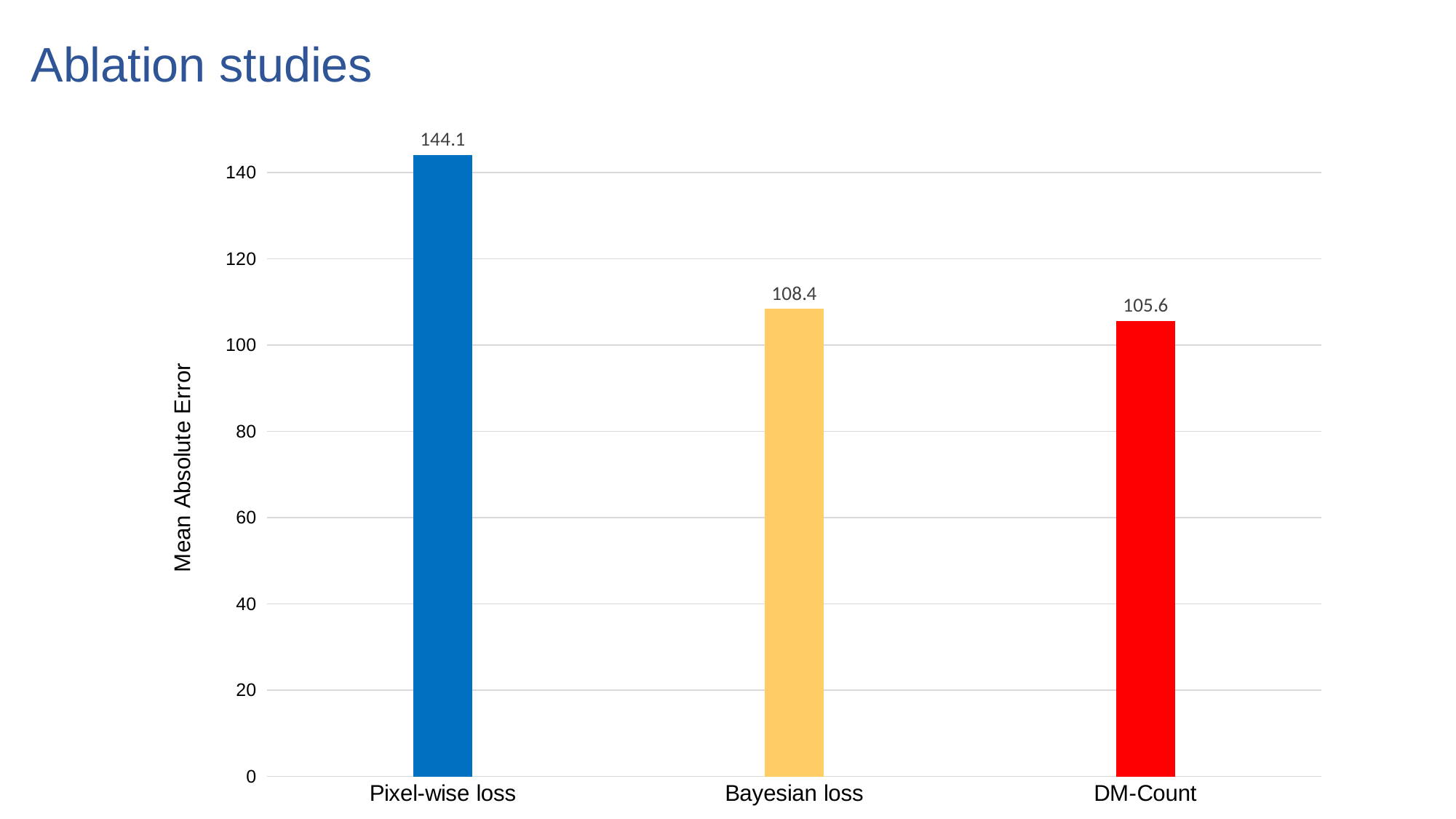
What is the difference in Mean Absolute Error between Bayesian loss and DM-Count? 2.8 Which method has the lowest Mean Absolute Error? DM-Count How many methods are shown on the chart? 3 Which method has the highest Mean Absolute Error? Pixel-wise loss What is the Mean Absolute Error for Pixel-wise loss? 144.1 Which has a larger Mean Absolute Error, Pixel-wise loss or Bayesian loss? Pixel-wise loss What is the difference in Mean Absolute Error between Pixel-wise loss and DM-Count? 38.5 What is the label of the vertical axis? Mean Absolute Error Is the value for Pixel-wise loss greater or less than 140? greater What is the Mean Absolute Error for Bayesian loss? 108.4 What kind of chart is shown on the slide? Bar chart What is the Mean Absolute Error for DM-Count? 105.6